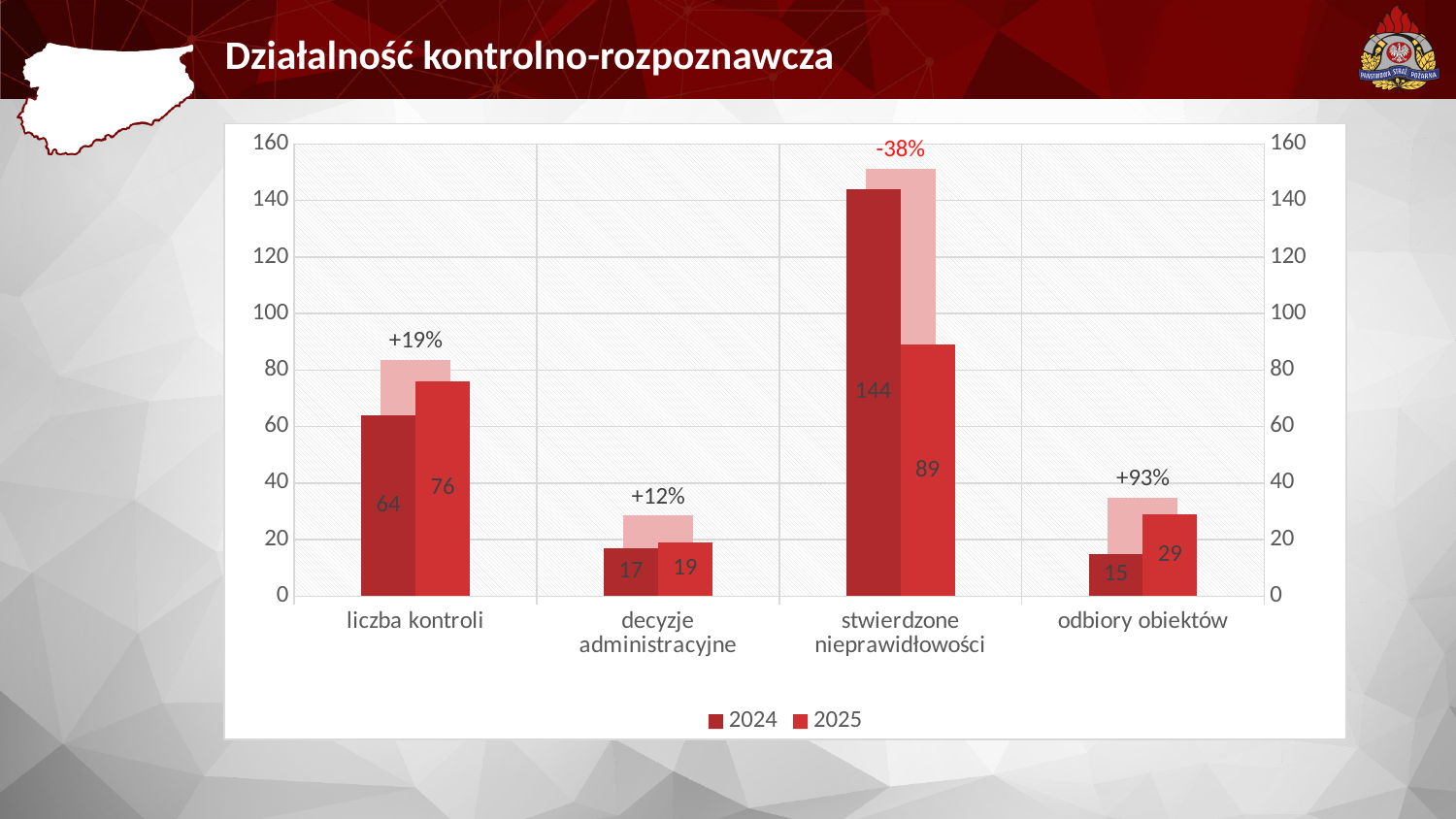
How many series does the legend list? 2 Is the 2024 value for 'stwierdzone nieprawidłowości' greater or less than 120? greater What is the value for 2025 in the 'odbiory obiektów' category? 29 What is the difference between the 2024 and 2025 values for 'stwierdzone nieprawidłowości'? 55 What is the value for 2025 in the 'stwierdzone nieprawidłowości' category? 89 Which category has the highest value for 2024? stwierdzone nieprawidłowości What kind of chart is shown on the slide? bar chart Which is larger for 'odbiory obiektów': the 2024 value or the 2025 value? 2025 What is the value for 2024 in the 'liczba kontroli' category? 64 How many categories are shown on the x axis? 4 What percentage change is labelled above the 'odbiory obiektów' bars? +93% Which category has the lowest value for 2025? decyzje administracyjne